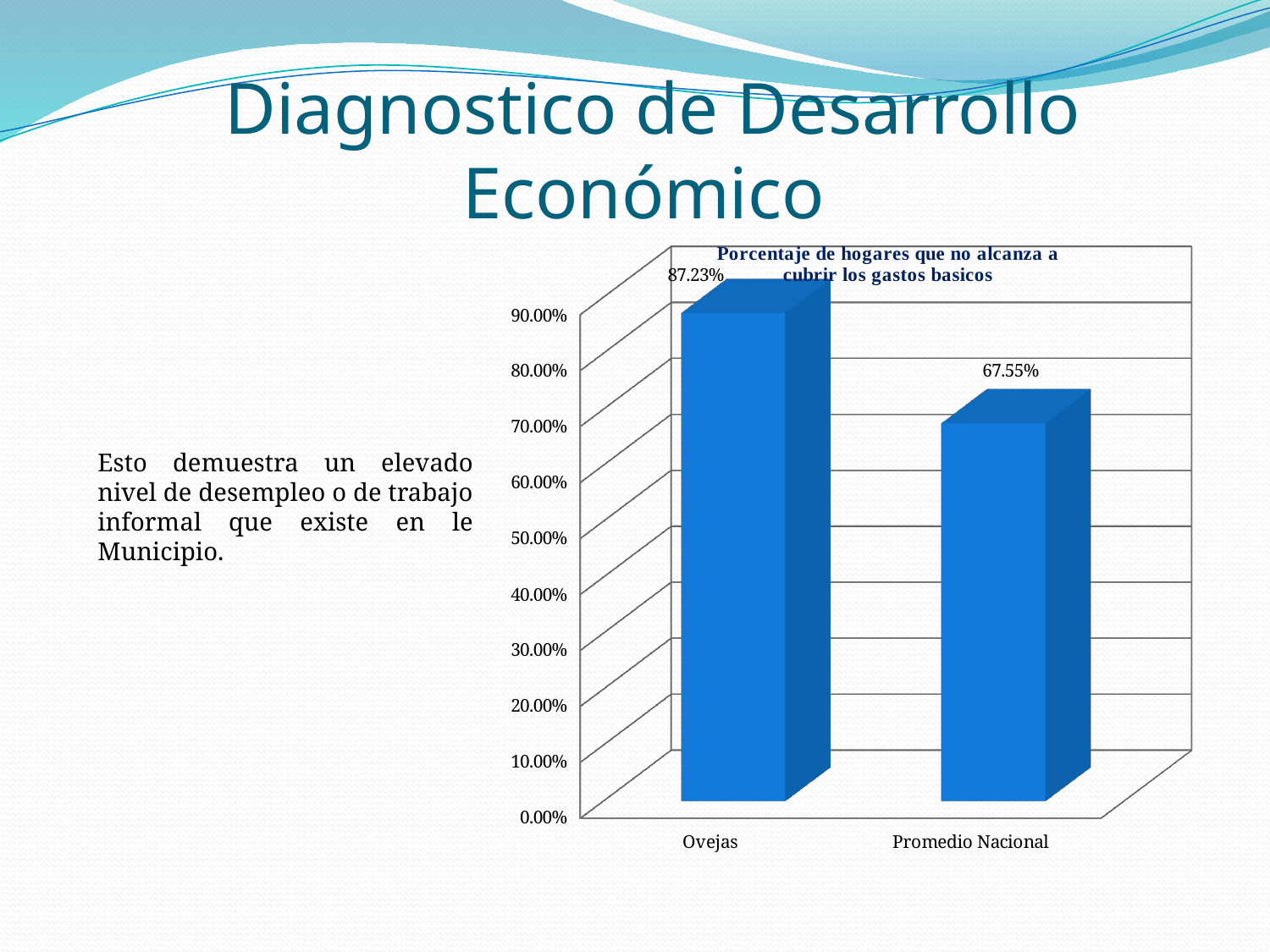
What is the title of the chart? Porcentaje de hogares que no alcanza a cubrir los gastos basicos What kind of chart is shown on the slide? Bar chart Which category has the lowest value? Promedio Nacional What is the value for Ovejas? 87.23% How many categories are shown on the chart? 2 What is the highest value shown on the vertical axis? 90.00% What is the difference between the values for Ovejas and Promedio Nacional? 19.68% Which category has the highest value? Ovejas Which is larger, the value for Ovejas or the value for Promedio Nacional? Ovejas Is the value for Ovejas greater or less than 80.00%? greater Is the value for Promedio Nacional greater or less than 70.00%? less What is the value for Promedio Nacional? 67.55%